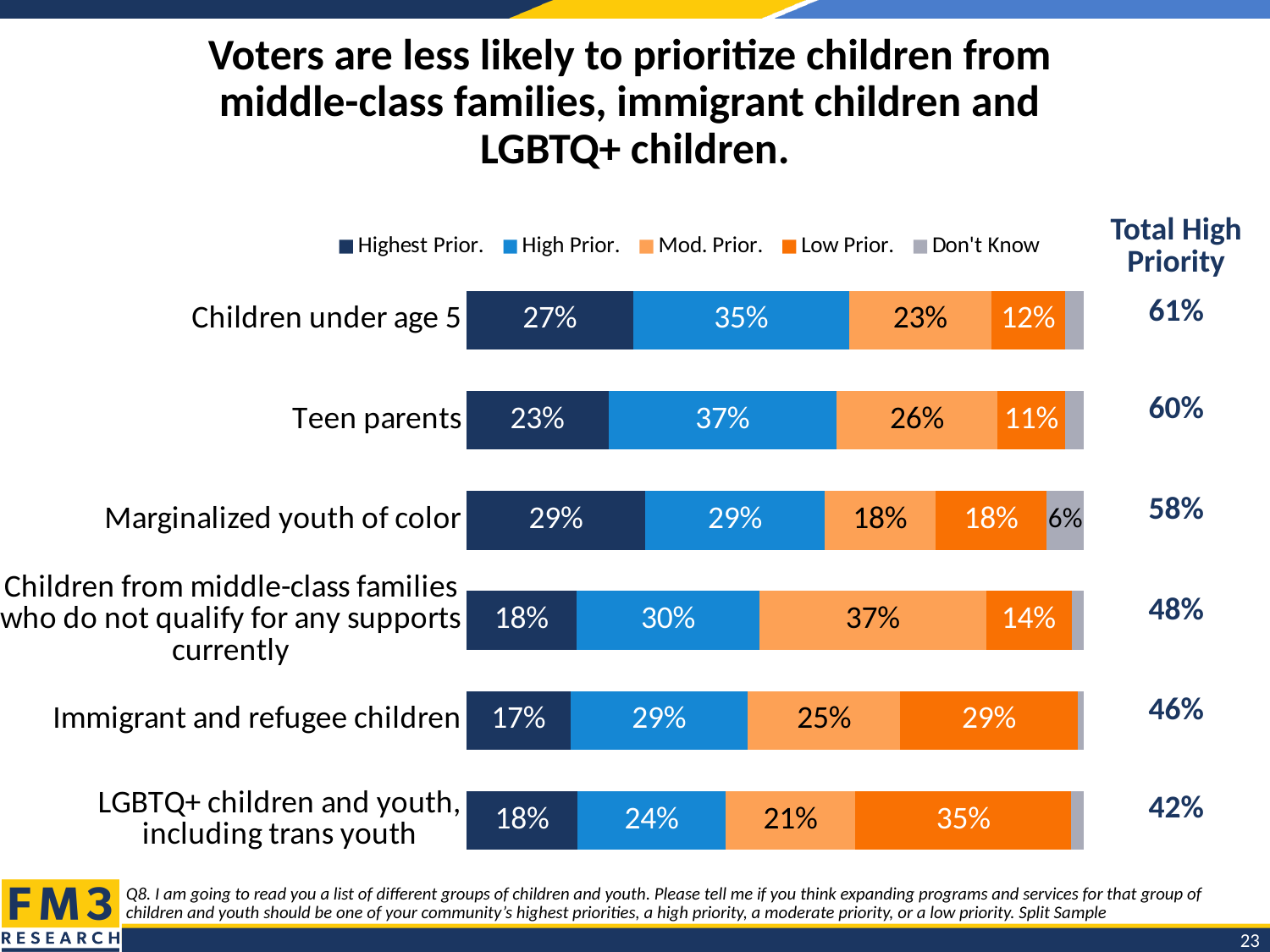
What percentage of voters rated children under age 5 as the highest priority? 27% Which has a larger Highest Prior. value: marginalized youth of color or teen parents? Marginalized youth of color What is the Low Prior. value for LGBTQ+ children and youth, including trans youth? 35% Which group has the highest Total High Priority value? Children under age 5 What is the Don't Know value for marginalized youth of color? 6% What kind of chart is shown on the slide? Stacked bar chart How many series does the legend list? 5 What is the Mod. Prior. value for children from middle-class families who do not qualify for any supports currently? 37% Which group has the largest Low Prior. share? LGBTQ+ children and youth, including trans youth Which group has the lowest Total High Priority value? LGBTQ+ children and youth, including trans youth How many groups of children and youth are shown in the chart? 6 What is the difference in Total High Priority between children under age 5 and LGBTQ+ children and youth? 19 percentage points